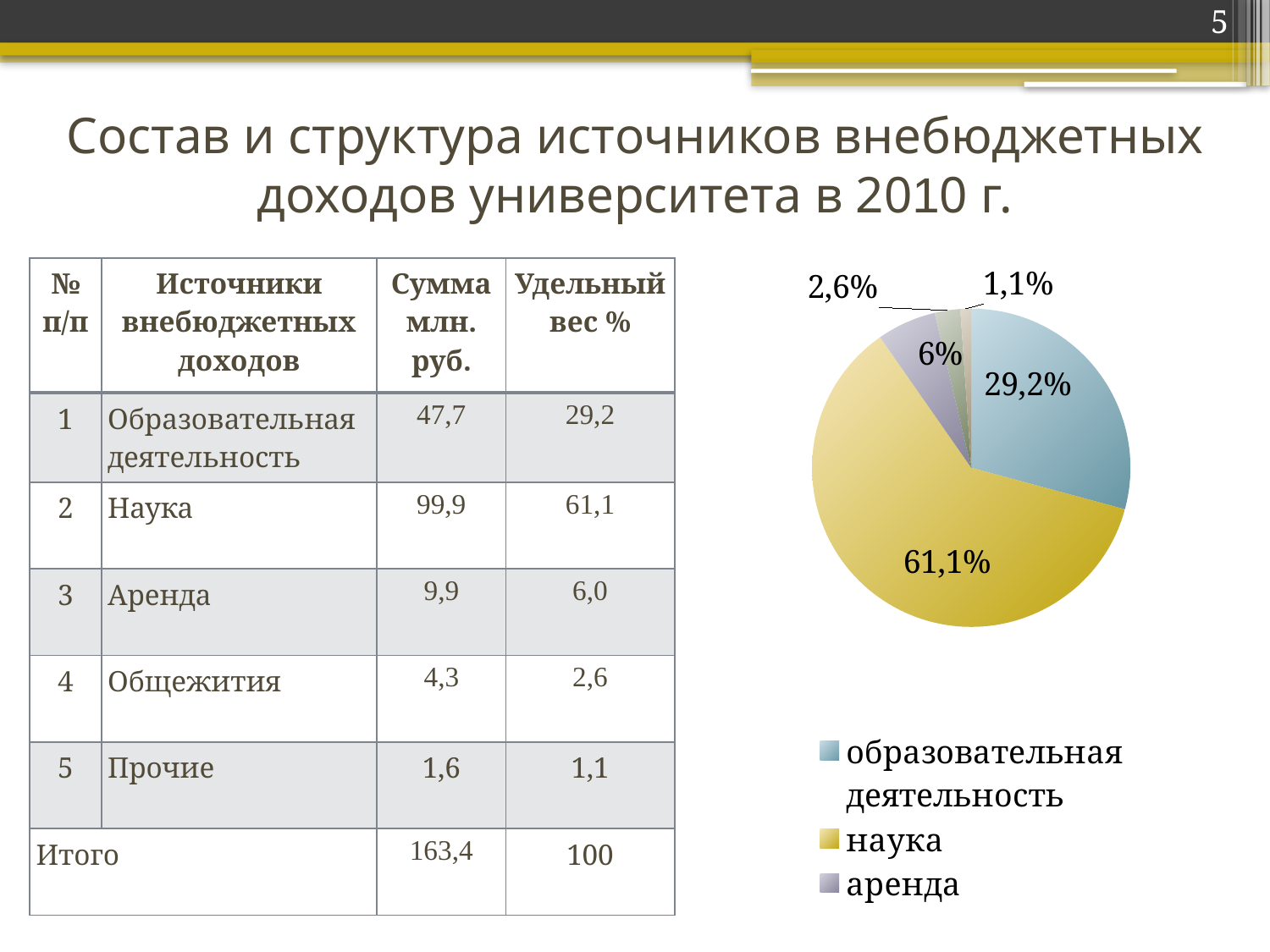
Which is larger in the pie chart: the share for наука or the share for образовательная деятельность? наука Which legend entry in the pie chart is shown in blue? образовательная деятельность How many slices does the pie chart have? 5 In the pie chart, what share is shown for наука? 61,1% In the pie chart, what share is shown for аренда? 6% What is the smallest percentage label shown on the pie chart? 1,1% What is the difference between the share for наука and the share for образовательная деятельность in the pie chart? 31,9% Which slice of the pie chart is the largest? наука In the pie chart, what share is shown for образовательная деятельность? 29,2% What kind of chart is shown on the slide? pie chart How many entries does the pie chart's legend list? 3 What colour is the slice for наука in the pie chart? yellow